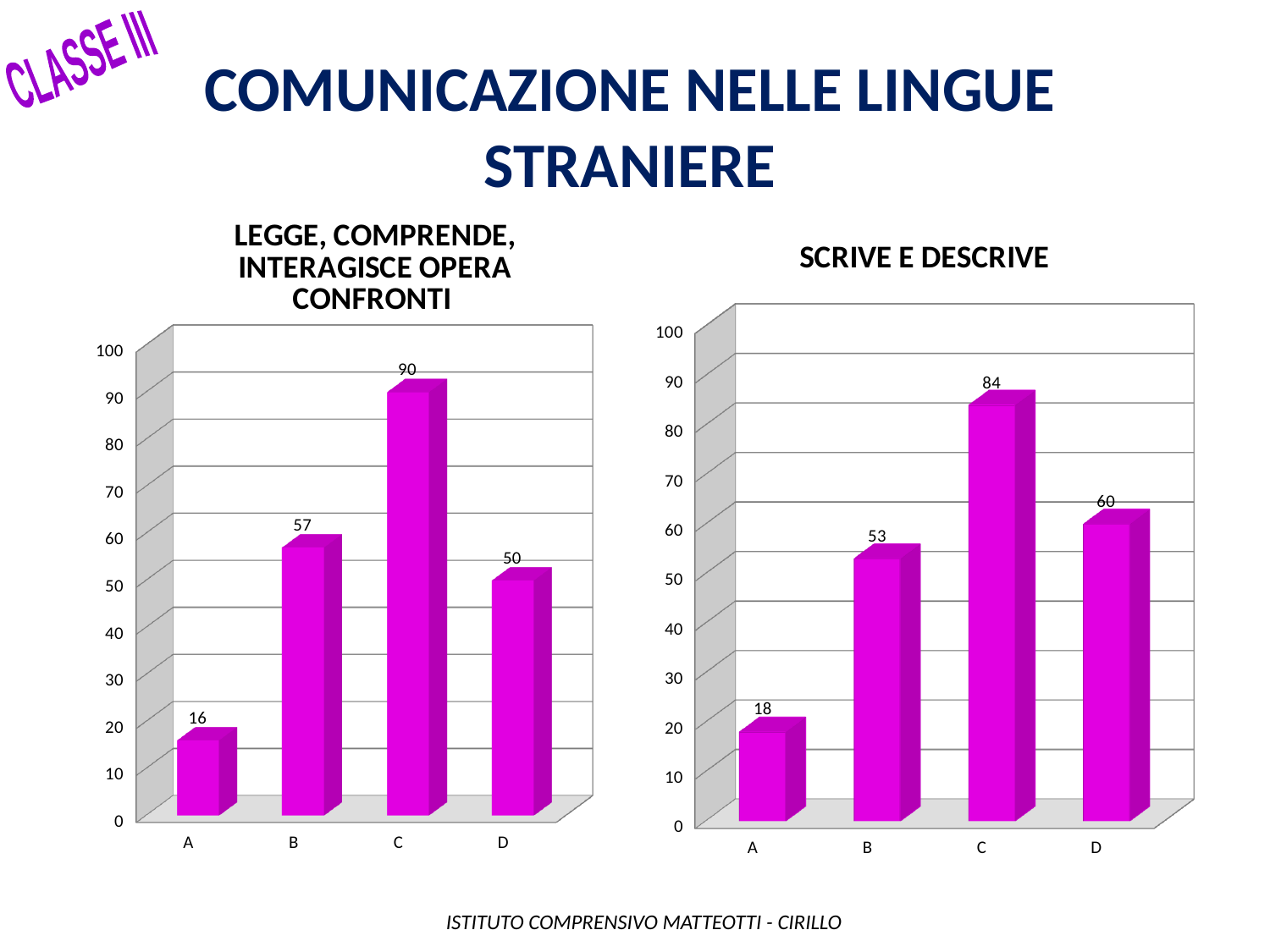
In the 'SCRIVE E DESCRIVE' chart, what is the difference between the values for B and A? 35 What is the title of the chart on the right side of the slide? SCRIVE E DESCRIVE In the 'LEGGE, COMPRENDE, INTERAGISCE OPERA CONFRONTI' chart, what is the difference between the values for C and D? 40 How many categories are shown in the 'SCRIVE E DESCRIVE' chart? 4 In the 'LEGGE, COMPRENDE, INTERAGISCE OPERA CONFRONTI' chart, what is the value for category C? 90 In the 'LEGGE, COMPRENDE, INTERAGISCE OPERA CONFRONTI' chart, which category has the lowest value? A In the 'LEGGE, COMPRENDE, INTERAGISCE OPERA CONFRONTI' chart, is the value for B greater or less than 50? greater In the 'SCRIVE E DESCRIVE' chart, which category has the highest value? C In the 'SCRIVE E DESCRIVE' chart, what is the value for category A? 18 In the 'SCRIVE E DESCRIVE' chart, what is the value for category D? 60 In the 'SCRIVE E DESCRIVE' chart, which is larger, the value for B or the value for D? D What kind of chart is the 'LEGGE, COMPRENDE, INTERAGISCE OPERA CONFRONTI' chart? Bar chart